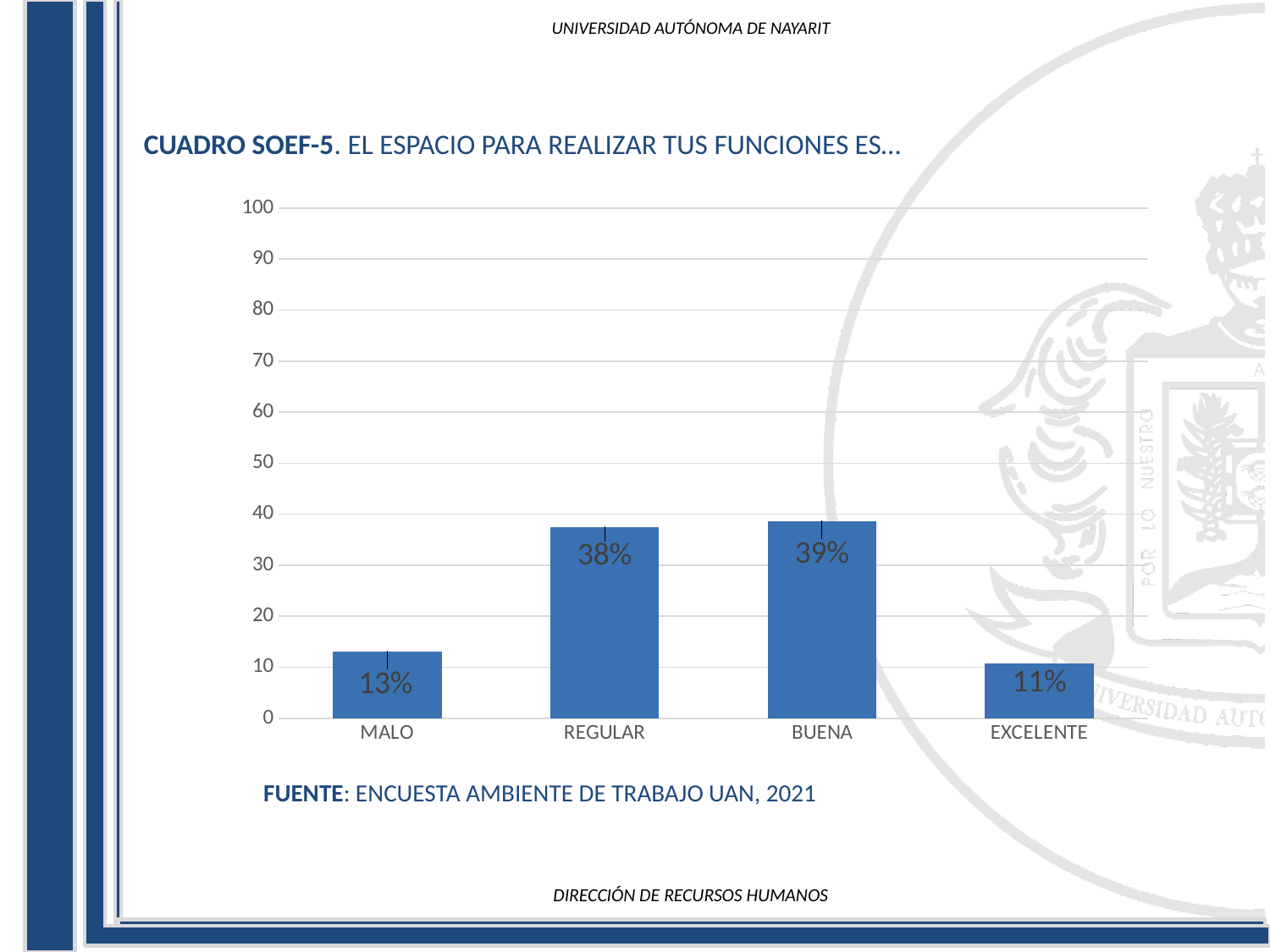
Which is larger, the value for REGULAR or the value for EXCELENTE? REGULAR What is the difference between the values for MALO and EXCELENTE? 2% How many categories are shown on the x axis? 4 Which category has the lowest value? EXCELENTE What kind of chart is shown on the slide? bar chart What is the difference between the values for BUENA and MALO? 26% What is the value for MALO? 13% Is the value for BUENA greater or less than 30? greater What is the value for EXCELENTE? 11% Which category has the highest value? BUENA What is the value for REGULAR? 38% What source is cited below the chart? ENCUESTA AMBIENTE DE TRABAJO UAN, 2021